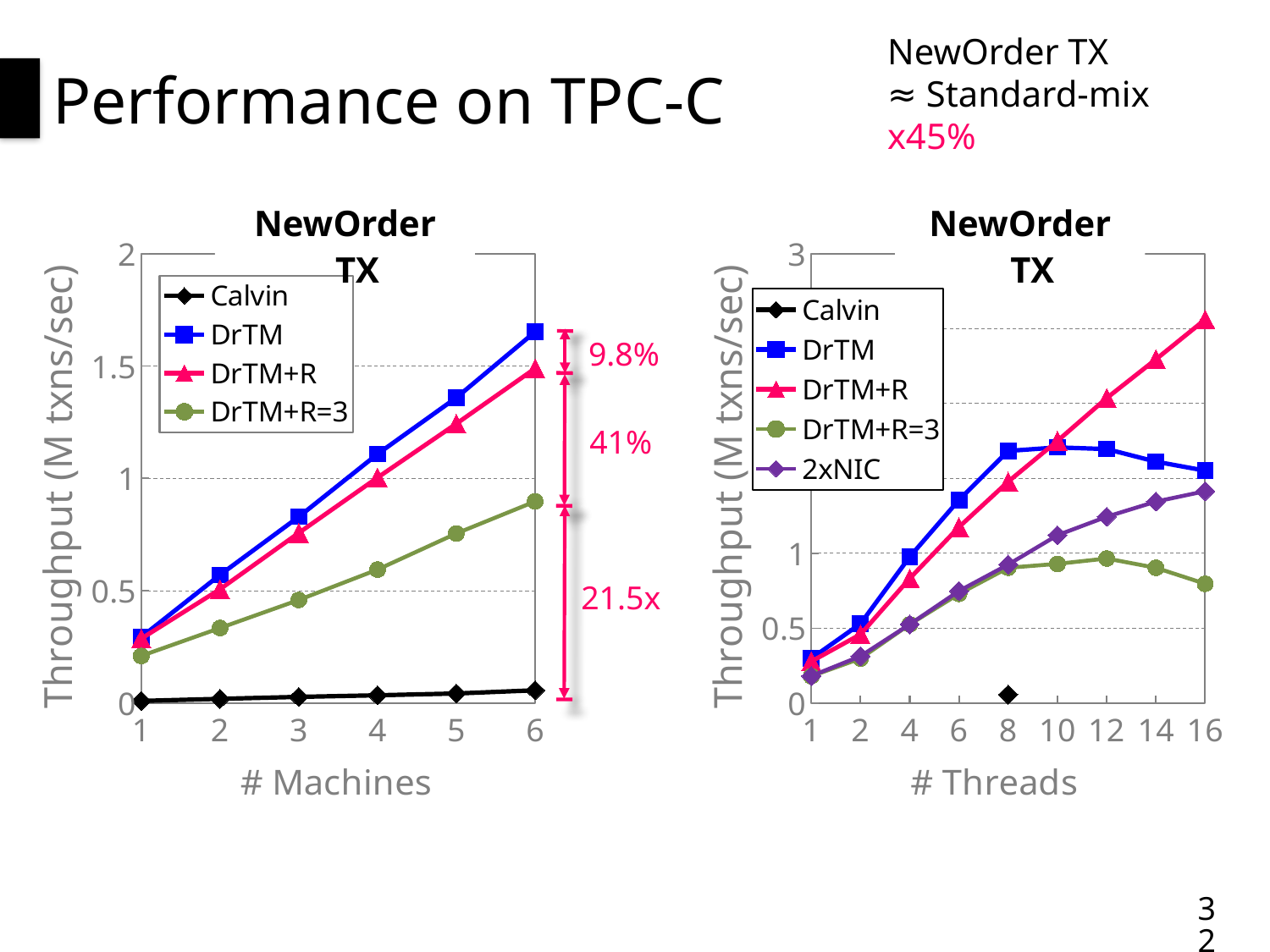
In the right chart (x axis # Threads), which is larger at 16 threads: DrTM+R or 2xNIC? DrTM+R How many x-axis points (thread counts) are shown in the right chart (x axis # Threads)? 9 In the left chart (x axis # Machines), which series has the lowest throughput at 6 machines? Calvin In the left chart (x axis # Machines), does the DrTM throughput rise or fall as the number of machines increases? rise In the left chart (x axis # Machines), is the value for DrTM+R=3 at 6 machines greater or less than 1? less In the right chart (x axis # Threads), which series has the highest throughput at 16 threads? DrTM+R How many series does the legend of the left chart (x axis # Machines) list? 4 In the left chart (x axis # Machines), is the value for DrTM at 6 machines greater or less than 1.5? greater How many series does the legend of the right chart (x axis # Threads) list? 5 In the right chart (x axis # Threads), is the value for DrTM+R at 16 threads greater or less than 1.5? greater In the left chart (x axis # Machines), which series has the highest throughput at 6 machines? DrTM What kind of chart is the left chart (x axis # Machines)? line chart